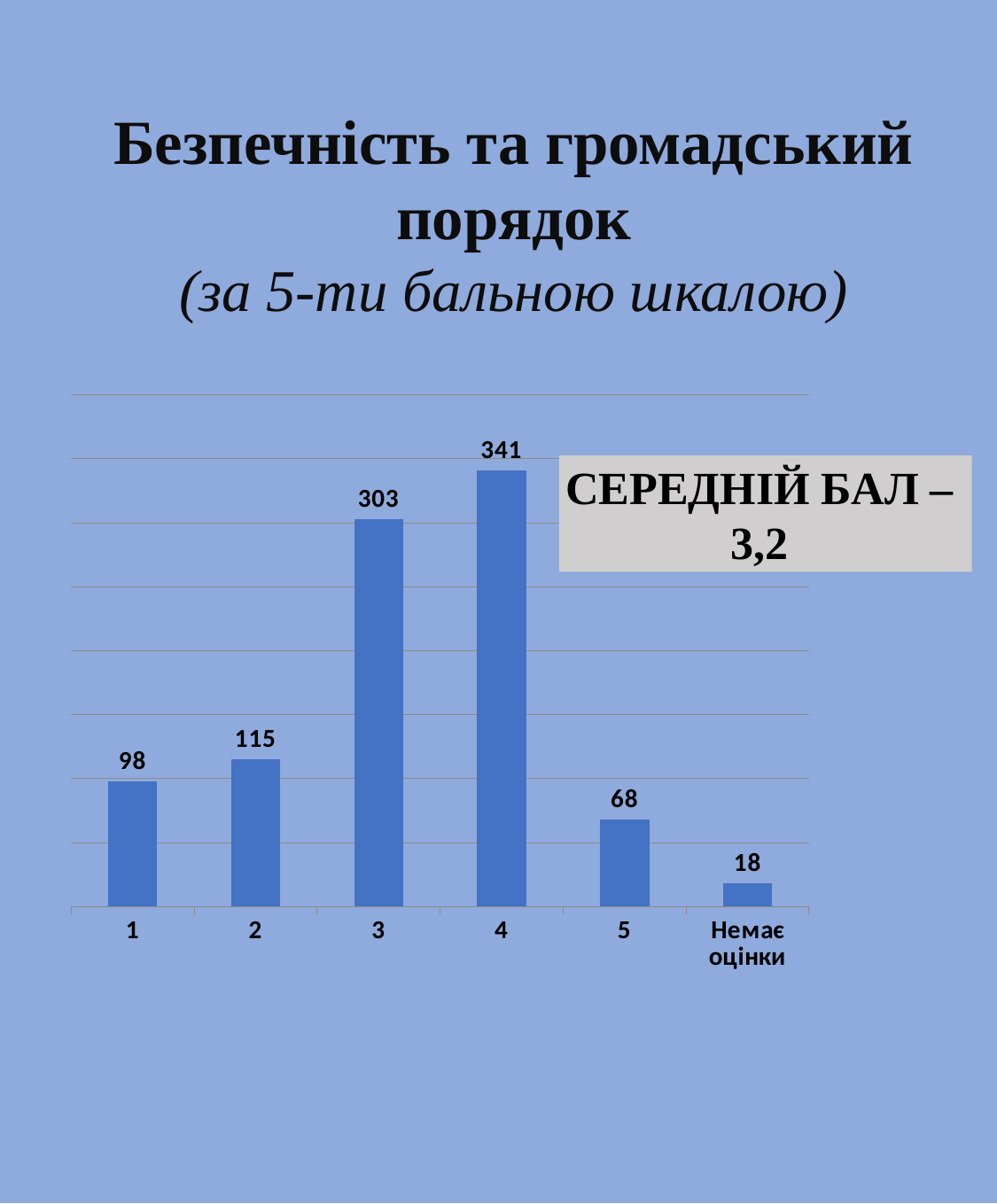
What is the value for category 1? 98 Which category has the highest value? 4 What is the difference between the values for categories 4 and 3? 38 What is the title of the chart on the slide? Безпечність та громадський порядок (за 5-ти бальною шкалою) What is the average score (середній бал) stated on the slide? 3,2 What is the difference between the values for categories 2 and 1? 17 What is the value for category 4? 341 How many categories are shown on the x axis? 6 What is the value for the "Немає оцінки" category? 18 Which category has the lowest value? Немає оцінки Which is larger, the value for category 2 or the value for category 5? 2 What kind of chart is shown on the slide? bar chart